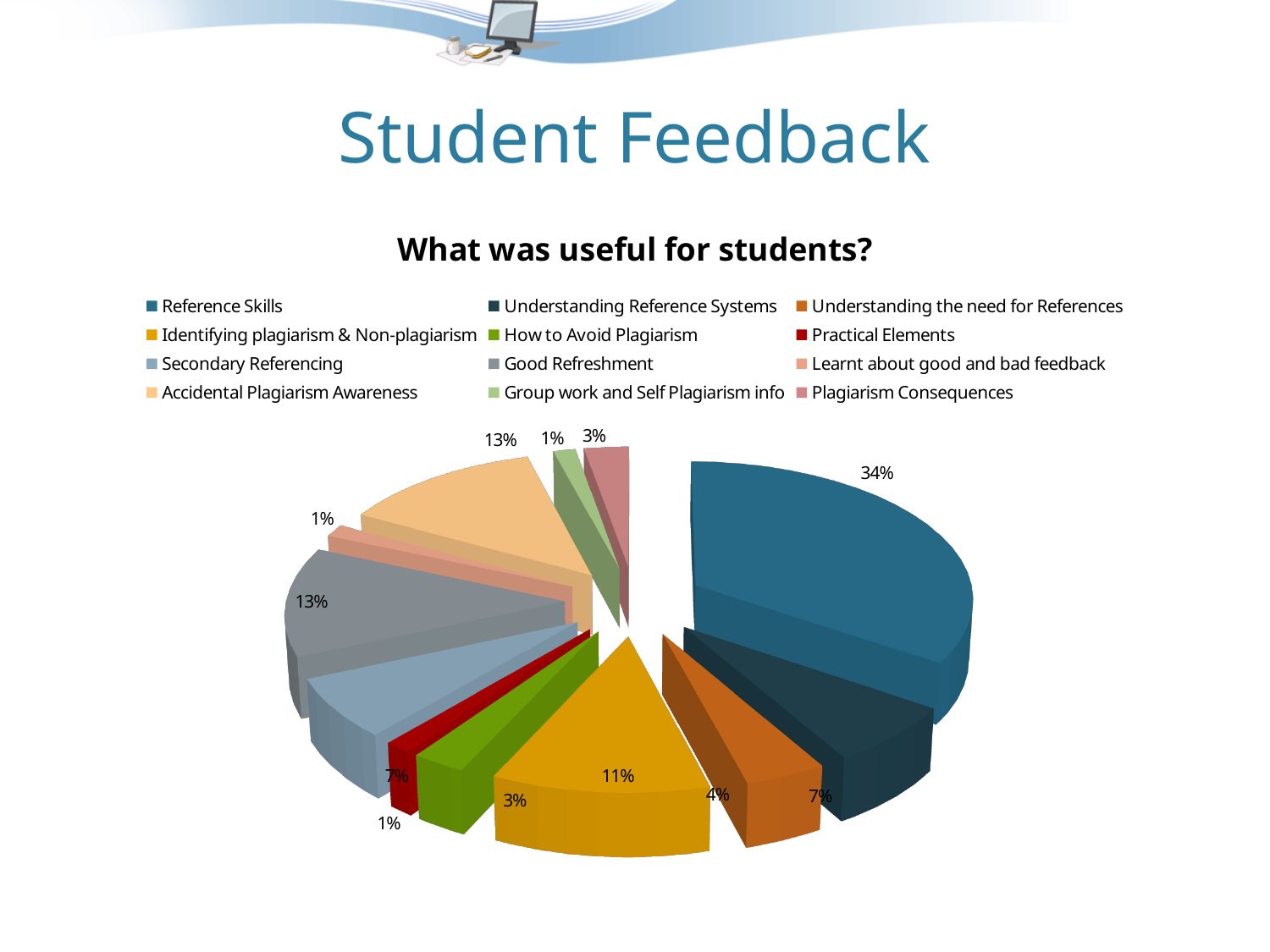
Which is larger, Understanding Reference Systems or How to Avoid Plagiarism? Understanding Reference Systems What percentage is shown for Good Refreshment? 13% What kind of chart is shown on the slide? pie chart What percentage is shown for Secondary Referencing? 7% What percentage is shown for Identifying plagiarism & Non-plagiarism? 11% What is the difference in percentage points between Reference Skills and Accidental Plagiarism Awareness? 21 What percentage is shown for Understanding the need for References? 4% What is the title of the chart? What was useful for students? How many categories does the legend list? 12 Which category has the largest slice of the pie? Reference Skills What share of the pie is Reference Skills? 34% What percentage is shown for Plagiarism Consequences? 3%